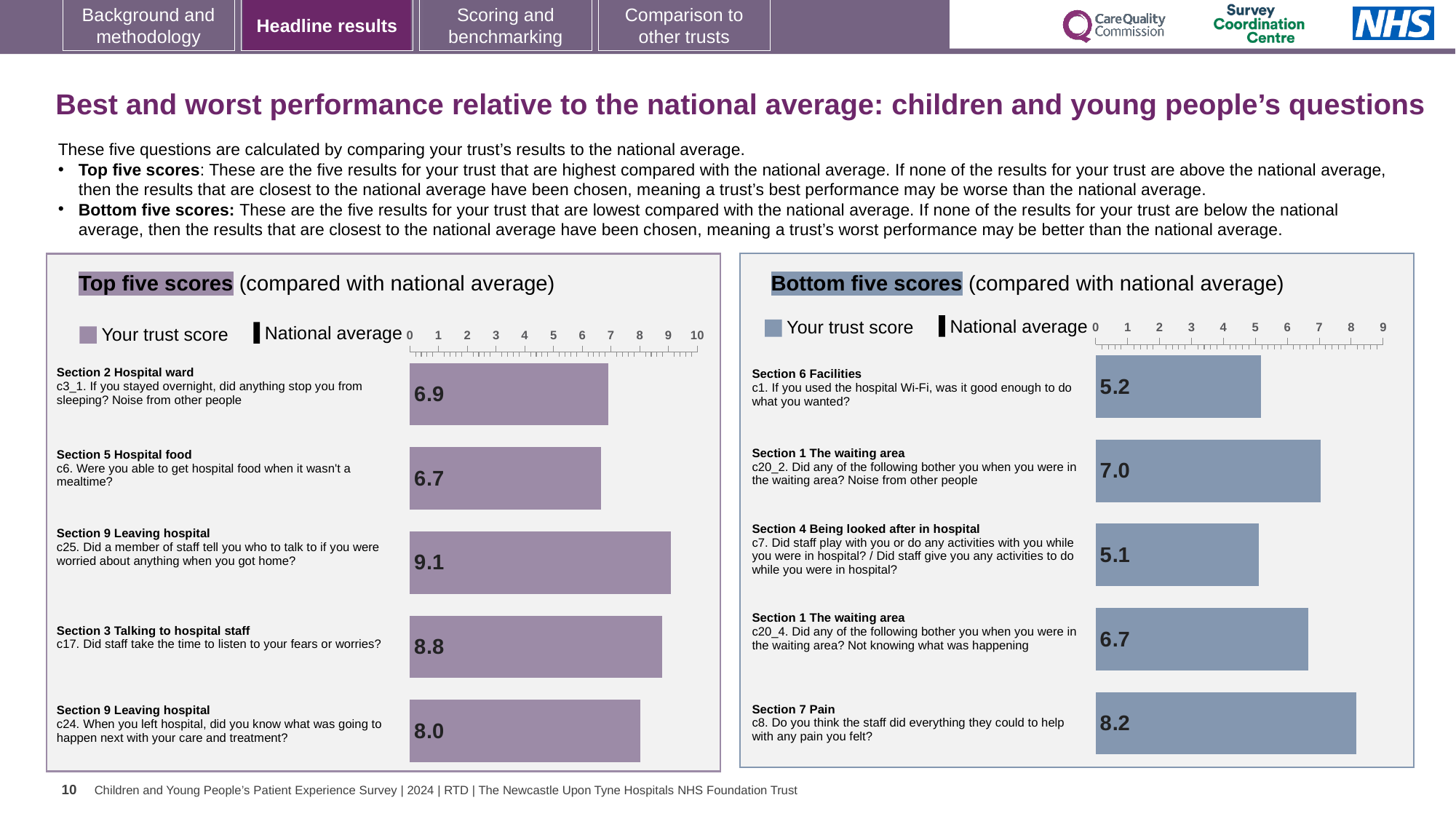
In the Top five scores chart, what is the trust score for c25 (Did a member of staff tell you who to talk to if you were worried about anything when you got home?)? 9.1 In the Bottom five scores chart, what is the trust score for c8 (Do you think the staff did everything they could to help with any pain you felt?)? 8.2 In the Bottom five scores chart, what is the trust score for c1 (If you used the hospital Wi-Fi, was it good enough to do what you wanted?)? 5.2 In the Top five scores chart, what is the difference between the highest trust score (c25) and the lowest trust score (c6)? 2.4 How many questions are shown in the Bottom five scores chart? 5 How many series does the legend of the Top five scores chart list? 2 In the Bottom five scores chart, what is the difference between the trust scores for c8 and c7? 3.1 In the Top five scores chart, which has the larger trust score: c17 or c24? c17 In the Top five scores chart, which question has the highest trust score? c25. Did a member of staff tell you who to talk to if you were worried about anything when you got home? What kind of chart is the Bottom five scores chart? Bar chart In the Bottom five scores chart, which question has the lowest trust score? c7. Did staff play with you or do any activities with you while you were in hospital? / Did staff give you any activities to do while you were in hospital? In the Top five scores chart, what is the trust score for c6 (Were you able to get hospital food when it wasn't a mealtime?)? 6.7